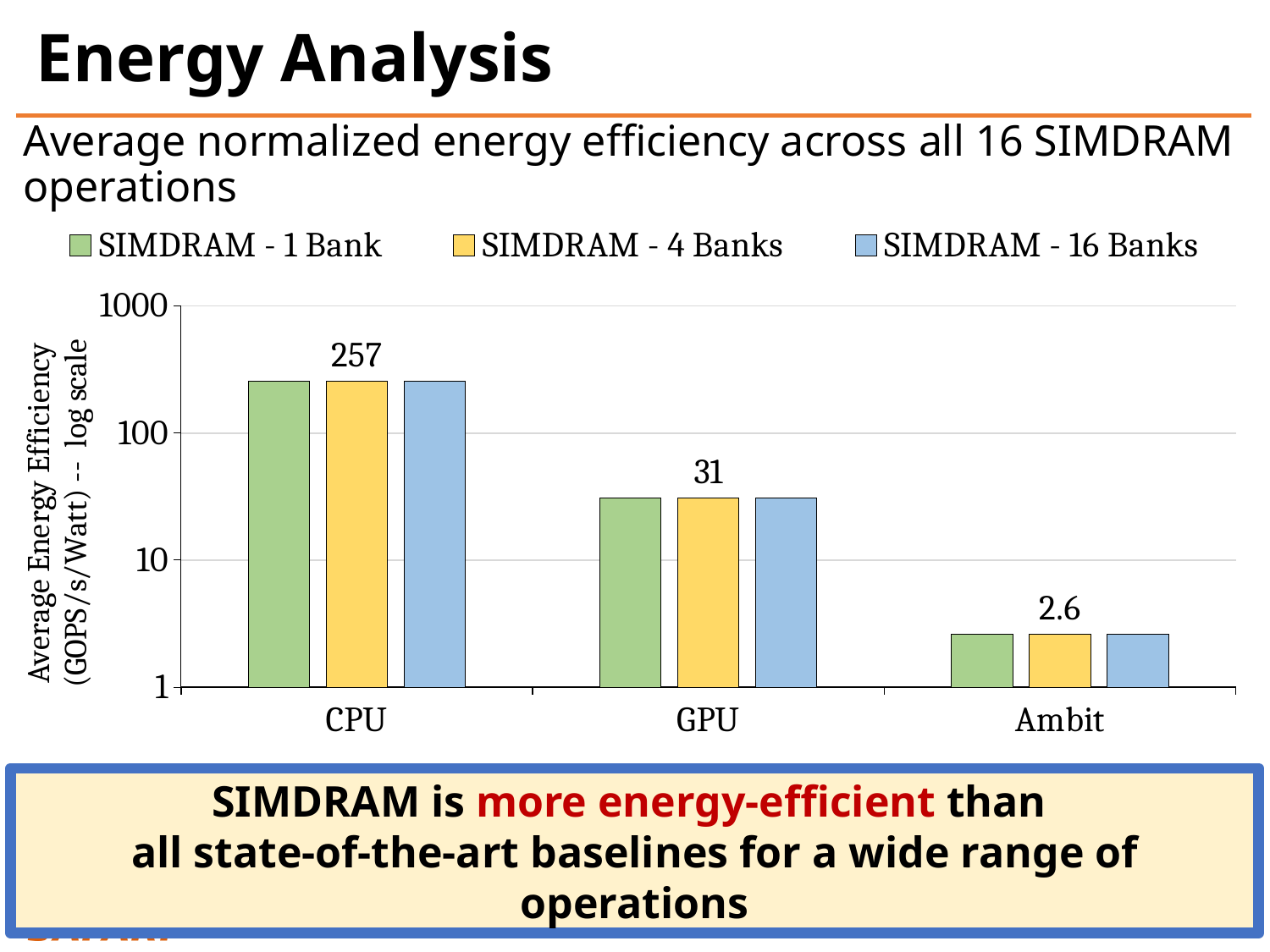
Is the value for SIMDRAM - 1 Bank in the GPU category greater or less than 100? less Do the values rise or fall moving from CPU to Ambit along the x axis? fall What is the labeled value for SIMDRAM - 4 Banks in the GPU category? 31 Which category has the lowest energy efficiency values? Ambit What is the y-axis label of the chart? Average Energy Efficiency (GOPS/s/Watt) -- log scale How many categories are shown on the x axis? 3 What kind of chart is shown on the slide? bar chart How many series does the legend list? 3 What is the labeled value for SIMDRAM - 4 Banks in the CPU category? 257 What is the labeled value for SIMDRAM - 4 Banks in the Ambit category? 2.6 Is the labeled value for CPU larger or smaller than the labeled value for GPU? larger Which category has the highest energy efficiency values? CPU